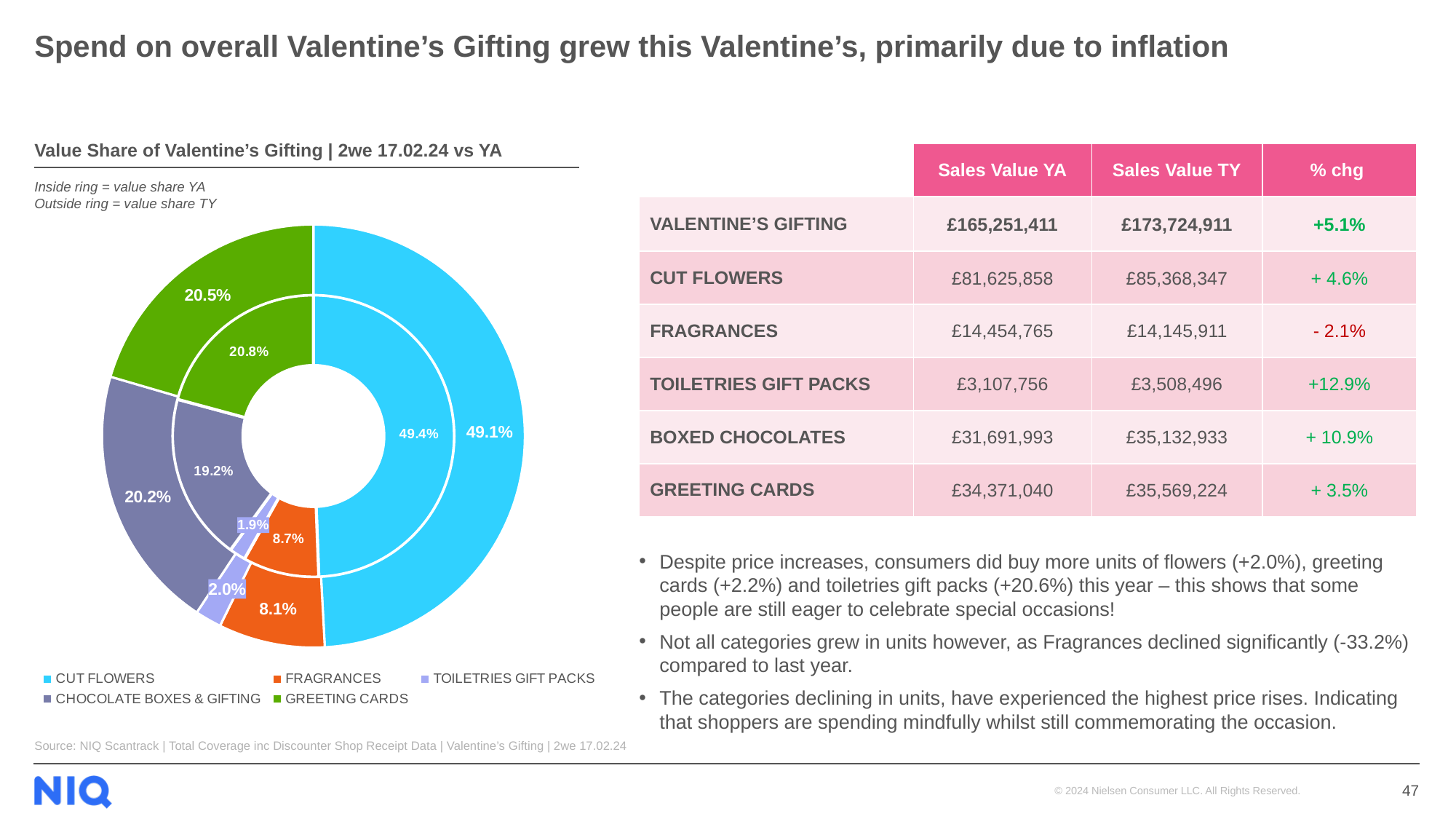
What is the value share of Greeting Cards in the outside ring (TY)? 20.5% Which category has the smallest value share in the inside ring (YA)? Toiletries Gift Packs What is the difference between the Chocolate Boxes & Gifting value share in the outside ring (20.2%) and the inside ring (19.2%)? 1.0% What kind of chart is shown on the slide? Doughnut chart What is the value share of Toiletries Gift Packs in the outside ring (TY)? 2.0% What is the value share of Cut Flowers in the outside ring (TY)? 49.1% What is the value share of Cut Flowers in the inside ring (YA)? 49.4% How many categories does the chart's legend list? 5 In the outside ring (TY), which is larger: the value share of Greeting Cards or Chocolate Boxes & Gifting? Greeting Cards What is the value share of Fragrances in the inside ring (YA)? 8.7% Which category has the largest value share in the outside ring (TY)? Cut Flowers According to the chart's note, which ring represents value share YA? Inside ring